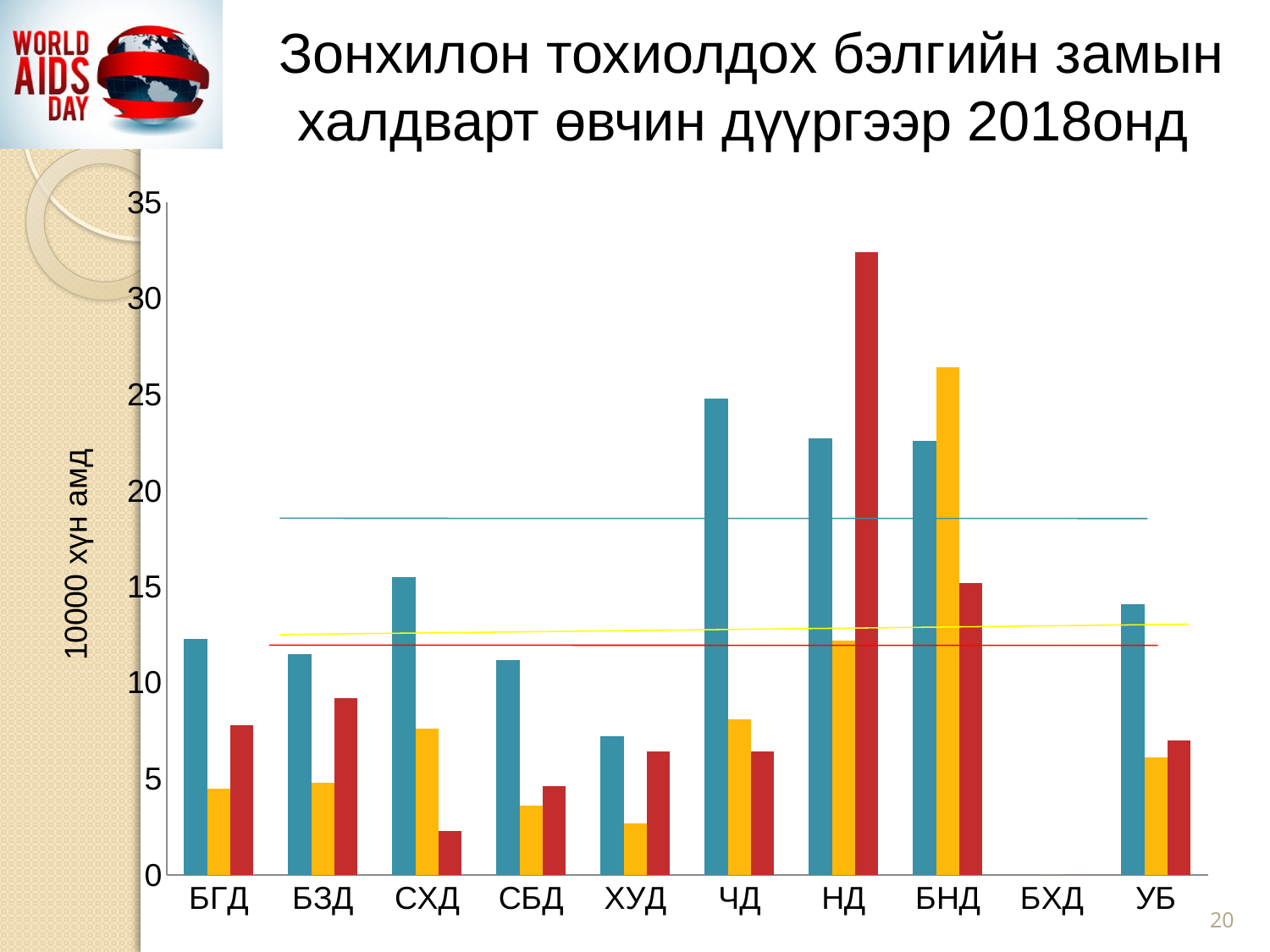
Is the blue bar for ХУД greater or less than 10? less Which category has the tallest blue bar? ЧД Which category has the tallest red bar? НД Which is larger, the blue bar for СХД or the blue bar for БГД? СХД Is the red bar for НД greater or less than 30? greater Which category has the shortest red bar? СХД What is the label on the vertical axis of the chart? 10000 хүн амд Which category has the tallest orange bar? БНД How many categories are shown on the x axis of the chart? 10 What kind of chart is shown on the slide? bar chart Which category on the x axis has no bars plotted? БХД Is the orange bar for БНД greater or less than 25? greater